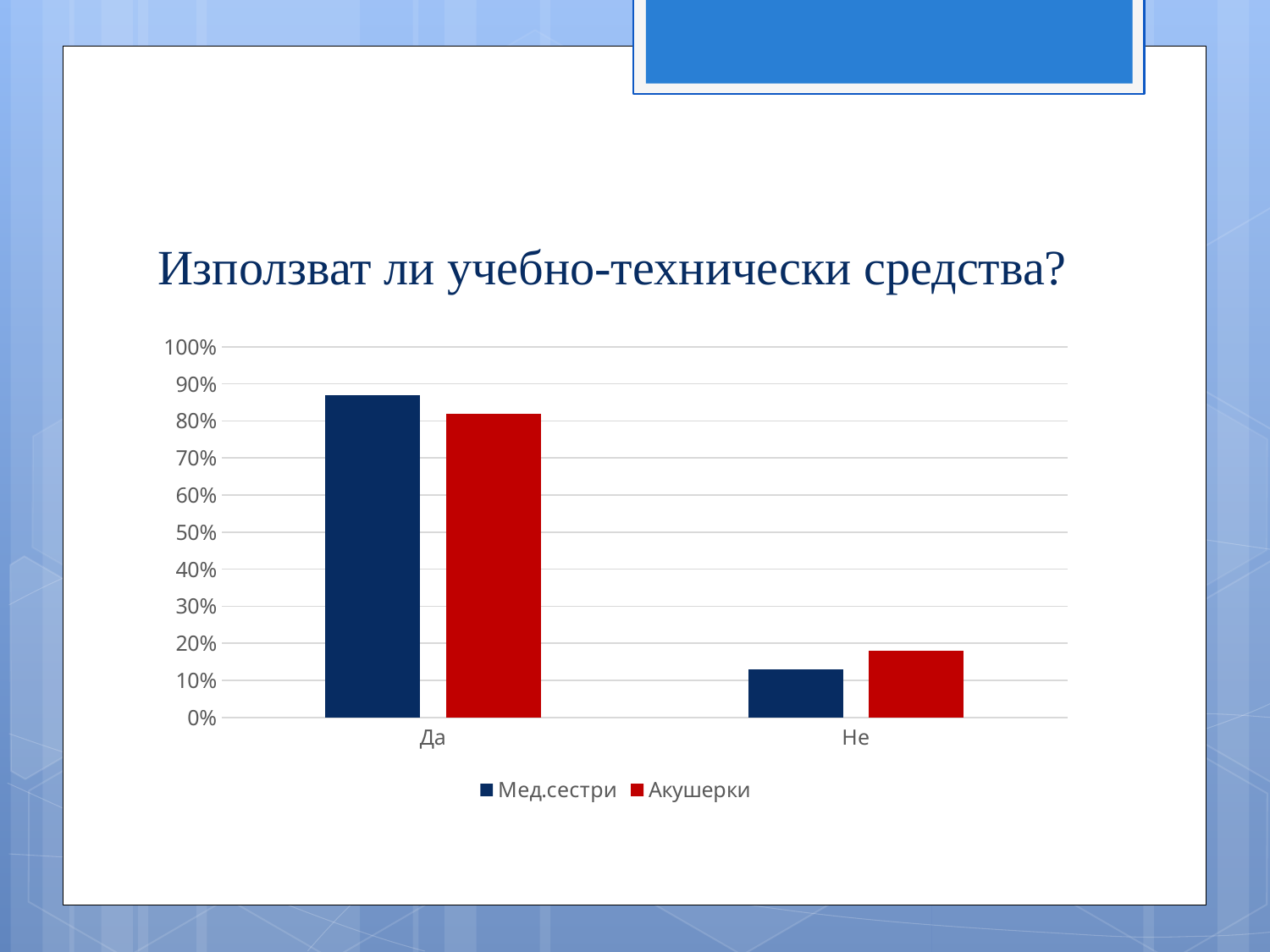
Which series is shown in red in the legend? Акушерки Is the value for Мед.сестри in the Не category greater or less than 10%? greater What kind of chart is shown on the slide? bar chart Is the value for Мед.сестри in the Не category greater or less than 20%? less In the Да category, which series has the larger value, Мед.сестри or Акушерки? Мед.сестри Is the value for Акушерки in the Да category greater or less than 90%? less In the Не category, which series has the larger value, Мед.сестри or Акушерки? Акушерки How many series does the legend list? 2 How many categories are shown on the x axis? 2 What is the title of the chart? Използват ли учебно-технически средства?